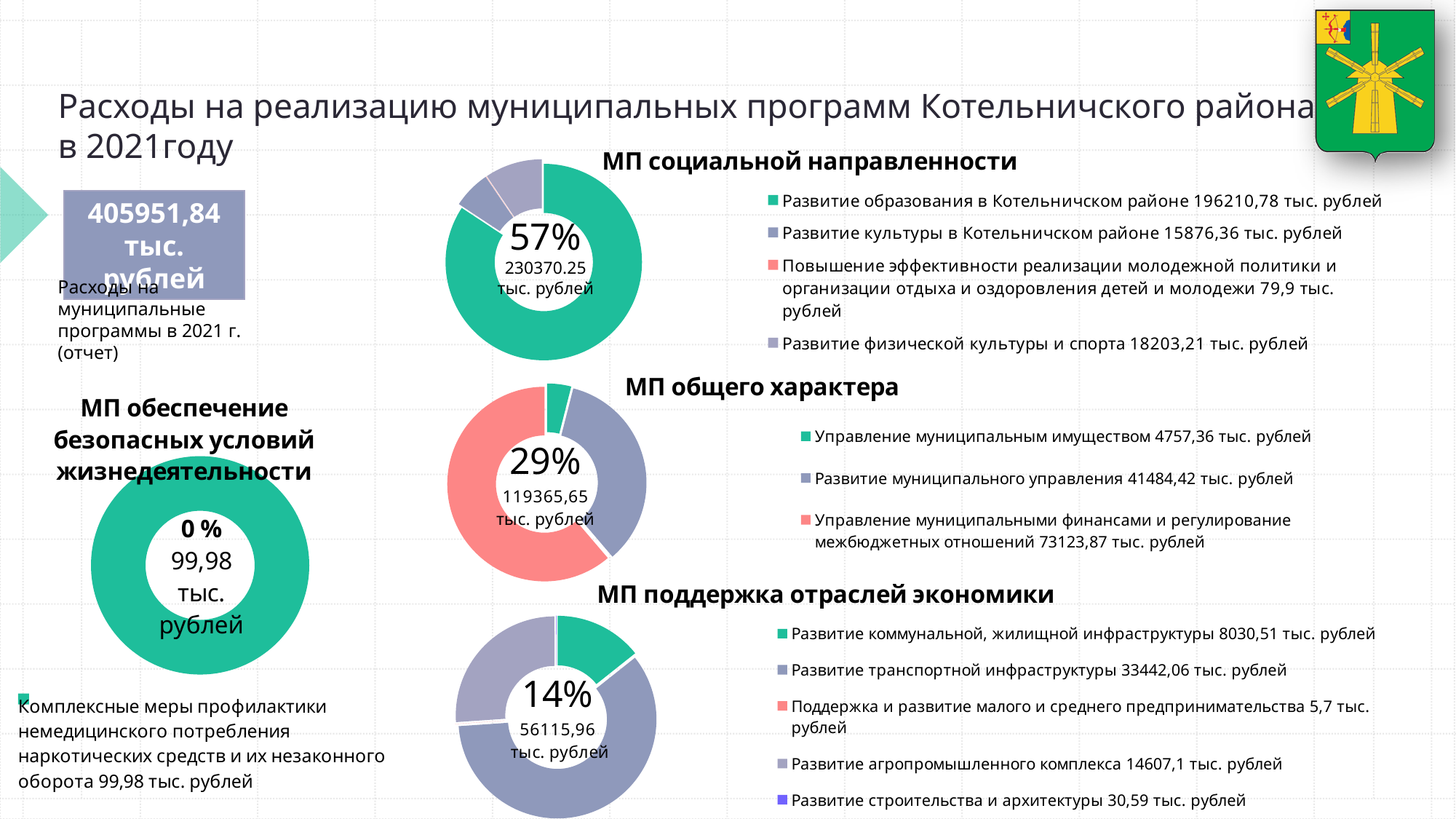
In the "МП общего характера" chart, what is the value for "Развитие муниципального управления"? 41484,42 тыс. рублей In the "МП обеспечение безопасных условий жизнедеятельности" chart, what value is printed in the centre of the donut? 99,98 тыс. рублей In the "МП социальной направленности" chart, what percentage is shown in the centre of the donut? 57% What kind of chart is used for "МП социальной направленности"? Pie (donut) chart In the "МП поддержка отраслей экономики" chart, what percentage is shown in the centre of the donut? 14% In the "МП социальной направленности" chart, which programme has the smallest value? Повышение эффективности реализации молодежной политики и организации отдыха и оздоровления детей и молодежи In the "МП общего характера" chart, which programme has the largest value? Управление муниципальными финансами и регулирование межбюджетных отношений How many entries does the legend of the "МП социальной направленности" chart list? 4 How many entries does the legend of the "МП поддержка отраслей экономики" chart list? 5 In the "МП общего характера" chart, what total value is printed in the centre of the donut? 119365,65 тыс. рублей In the "МП социальной направленности" chart, what is the value for "Развитие образования в Котельничском районе"? 196210,78 тыс. рублей In the "МП поддержка отраслей экономики" chart, which is larger: "Развитие транспортной инфраструктуры" or "Развитие агропромышленного комплекса"? Развитие транспортной инфраструктуры